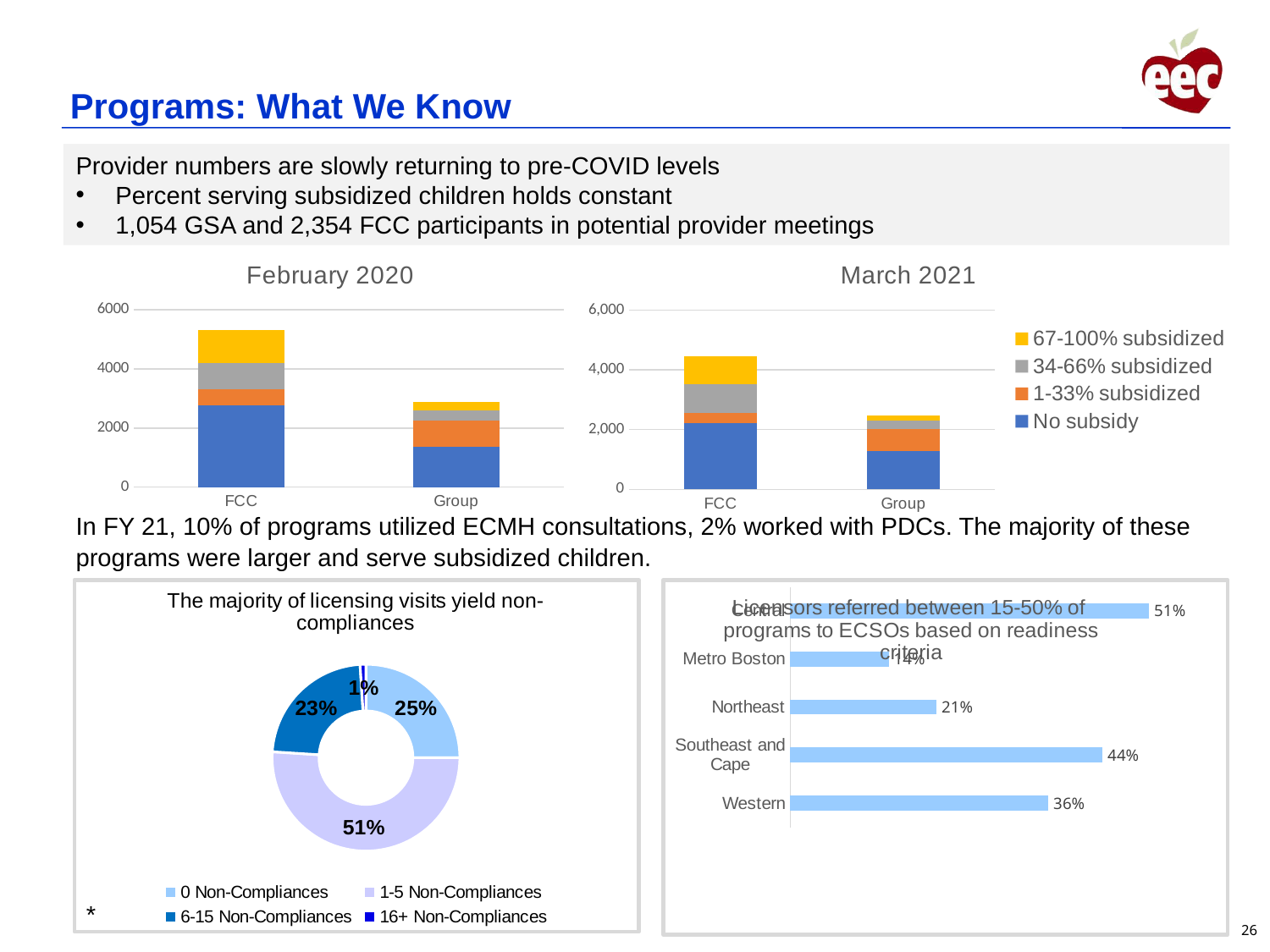
In the horizontal bar chart at the bottom right of the slide, which region has the lowest value? Metro Boston In the 'February 2020' chart, is the total for FCC greater or less than 4000? greater In the horizontal bar chart at the bottom right of the slide, how many regions are shown? 5 In the horizontal bar chart at the bottom right of the slide, which region has the highest value? Central In the horizontal bar chart at the bottom right of the slide, what is the value for Southeast and Cape? 44% In the donut chart titled 'The majority of licensing visits yield non-compliances', which category has the smallest share? 16+ Non-Compliances In the donut chart titled 'The majority of licensing visits yield non-compliances', how many categories does the legend list? 4 In the 'February 2020' chart, which category has the taller stacked bar, FCC or Group? FCC In the donut chart titled 'The majority of licensing visits yield non-compliances', what percentage of visits had 1-5 Non-Compliances? 51% In the donut chart titled 'The majority of licensing visits yield non-compliances', what percentage of visits had 0 Non-Compliances? 25% In the horizontal bar chart at the bottom right of the slide, what is the difference between the values for Central and Western? 15 percentage points In the donut chart titled 'The majority of licensing visits yield non-compliances', how many percentage points larger is the 1-5 Non-Compliances share than the 0 Non-Compliances share? 26 percentage points